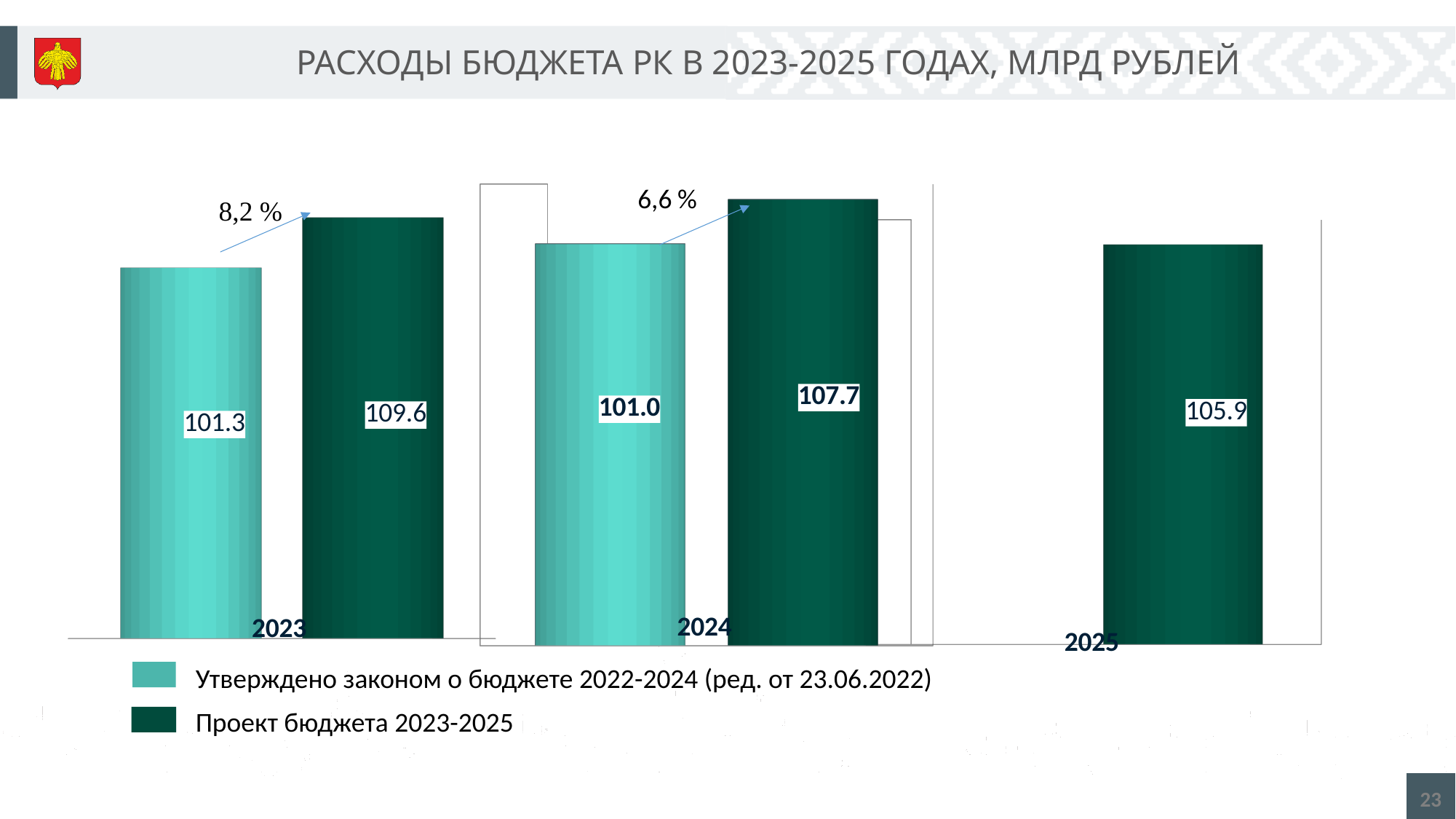
What is the value for 'Проект бюджета 2023-2025' in 2025? 105.9 Which year has the highest value for 'Проект бюджета 2023-2025'? 2023 What is the value for 'Утверждено законом о бюджете 2022-2024 (ред. от 23.06.2022)' in 2023? 101.3 What is the value for 'Проект бюджета 2023-2025' in 2023? 109.6 What kind of chart is shown on the slide? Bar chart How many series does the legend list? 2 What percentage increase is annotated above the 2024 bars? 6,6 % How many years are shown on the x axis? 3 In 2023, which is larger: the 'Проект бюджета 2023-2025' value or the 'Утверждено законом о бюджете 2022-2024' value? Проект бюджета 2023-2025 What is the value for 'Утверждено законом о бюджете 2022-2024 (ред. от 23.06.2022)' in 2024? 101.0 What is the difference between the 'Проект бюджета 2023-2025' value and the 'Утверждено законом о бюджете 2022-2024' value in 2024? 6.7 Which year has the lowest value for 'Проект бюджета 2023-2025'? 2025